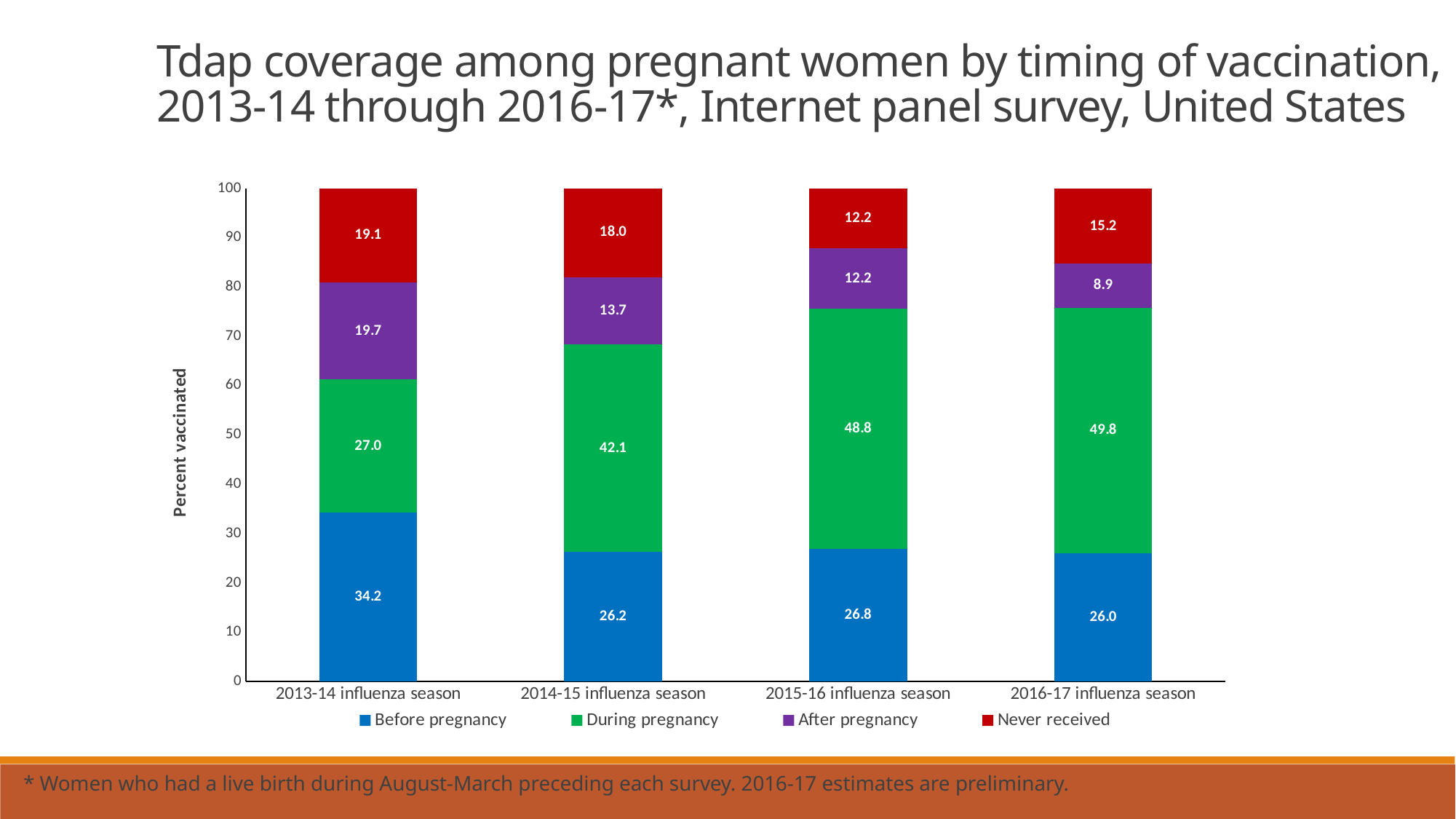
What is the value for After pregnancy in the 2016-17 influenza season? 8.9 What is the label on the y axis? Percent vaccinated How many influenza seasons are shown on the x axis? 4 How many series does the legend list? 4 Which is larger: the Never received value for 2014-15 or for 2016-17? 2014-15 influenza season What is the value for Never received in the 2013-14 influenza season? 19.1 Does the During pregnancy value rise or fall from the 2013-14 to the 2016-17 influenza season? Rise What is the difference between the During pregnancy values for the 2014-15 and 2013-14 influenza seasons? 15.1 What is the value for During pregnancy in the 2015-16 influenza season? 48.8 What kind of chart is shown on the slide? Stacked bar chart Which influenza season has the lowest value for After pregnancy? 2016-17 influenza season Which influenza season has the highest value for Before pregnancy? 2013-14 influenza season